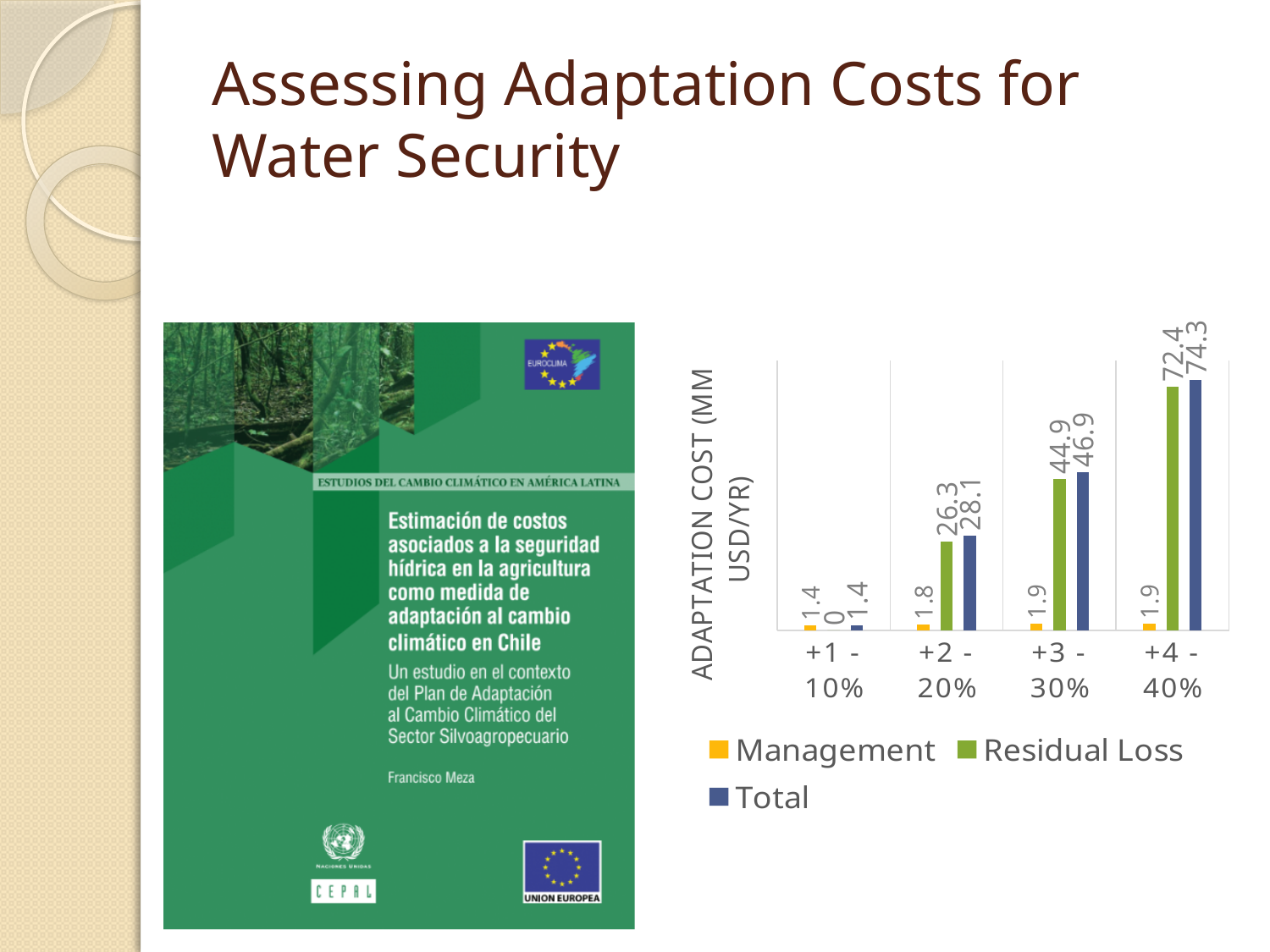
Do the Total values rise or fall from +1 - 10% to +4 - 40%? Rise What kind of chart is shown on the slide? Bar chart Is the Residual Loss value for +3 - 30% larger than the Residual Loss value for +2 - 20%? Yes Which category has the lowest Total value? +1 - 10% What is the difference between the Total values for +4 - 40% and +3 - 30%? 27.4 Which category has the highest Total value? +4 - 40% What is the Total value for the +4 - 40% category? 74.3 What is the Management value for the +3 - 30% category? 1.9 How many series does the legend list? 3 What is the Residual Loss value for the +1 - 10% category? 0 What is the Residual Loss value for the +2 - 20% category? 26.3 How many categories are shown on the x axis? 4